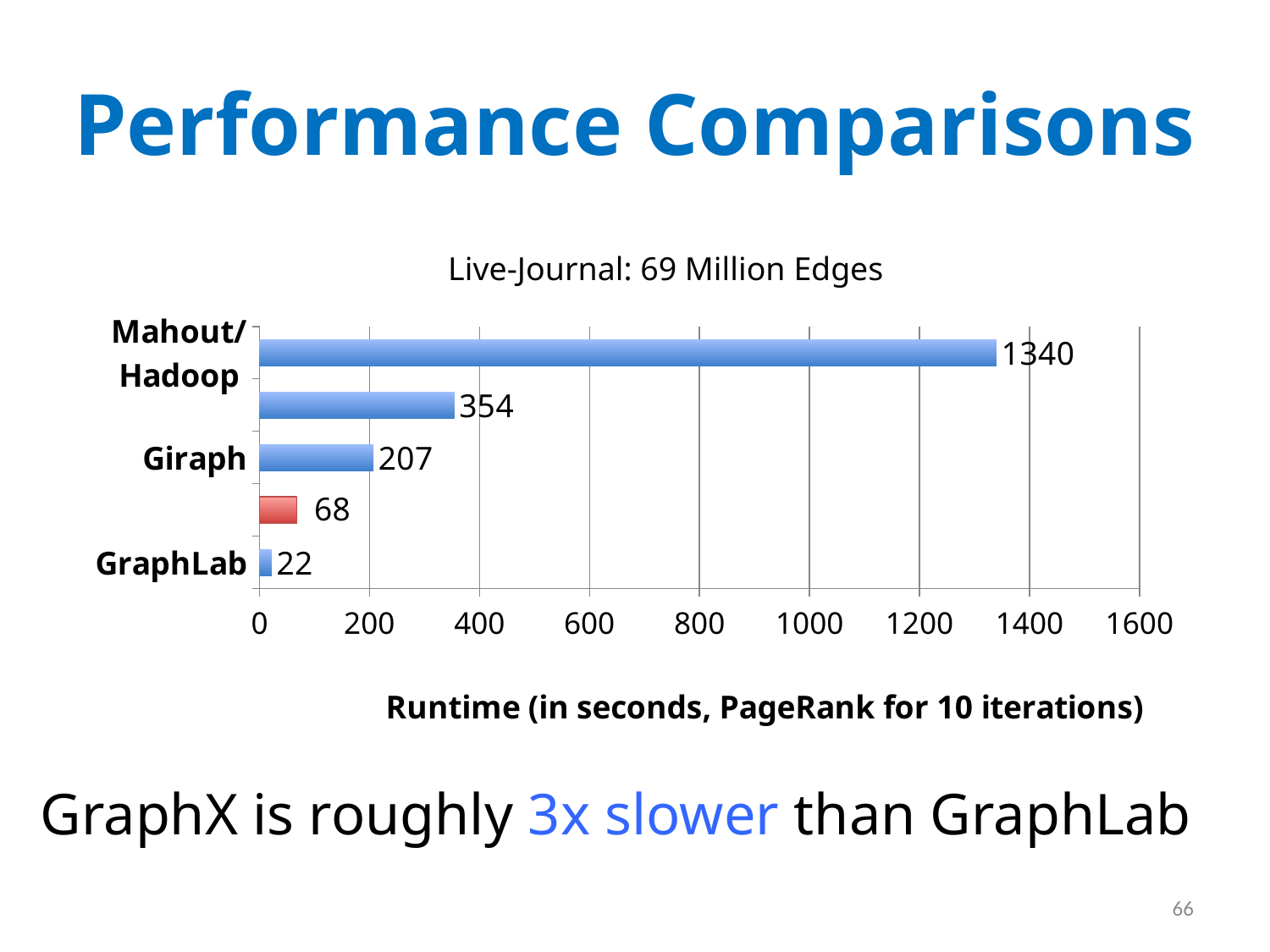
What is the runtime value shown for GraphLab? 22 What kind of chart is shown on the slide? bar chart How many bars are plotted in the chart? 5 What is the runtime value shown for Mahout/Hadoop? 1340 Which has a larger runtime, Giraph or GraphLab? Giraph Is the runtime for Mahout/Hadoop greater or less than 1200? greater Which labelled system has the highest runtime? Mahout/Hadoop What is the difference in runtime between Mahout/Hadoop and Giraph? 1133 What is the title of the chart? Live-Journal: 69 Million Edges Which labelled system has the lowest runtime? GraphLab What is the runtime value shown for Giraph? 207 What is the difference in runtime between Giraph and GraphLab? 185